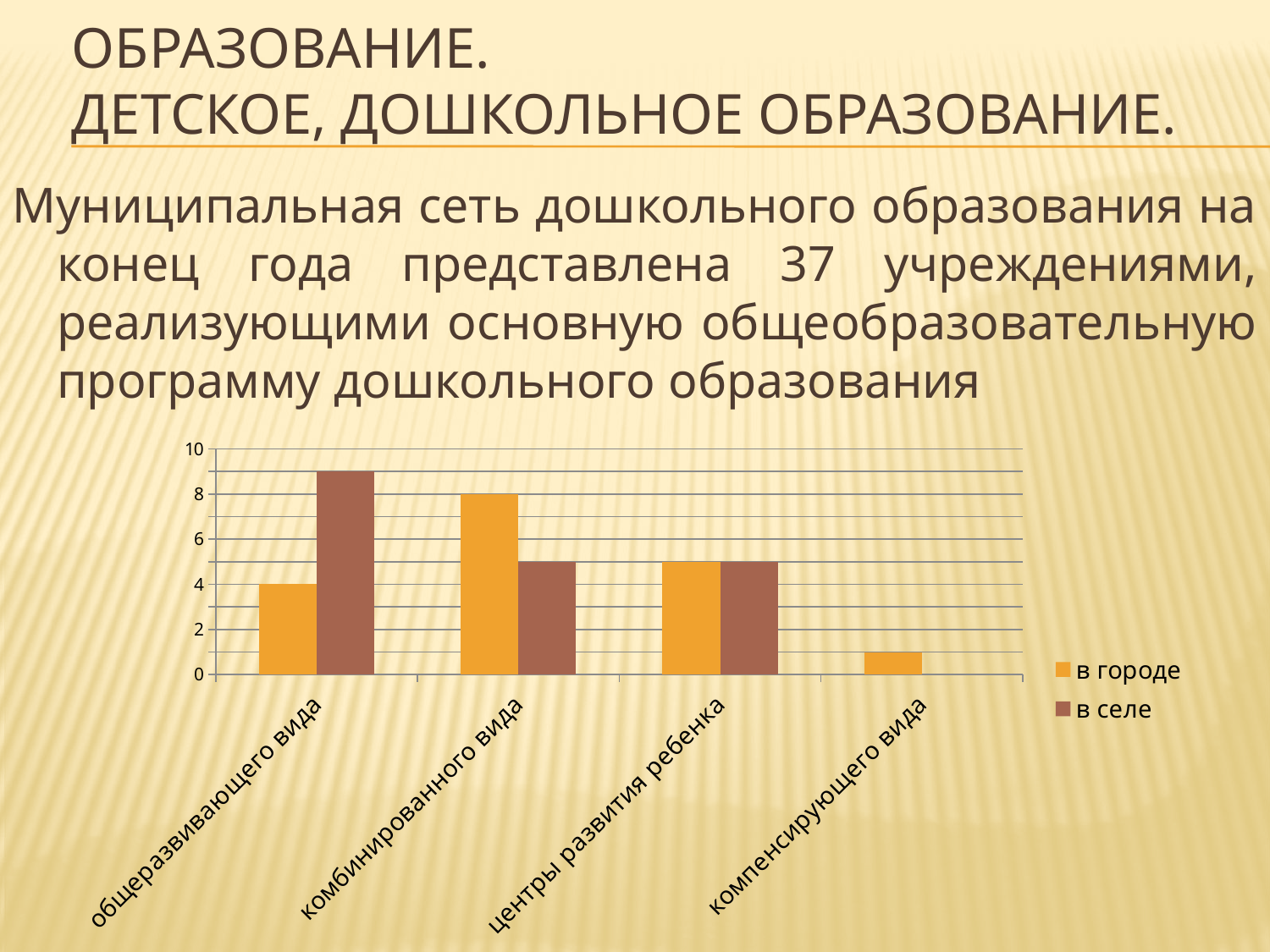
What is the value for 'в городе' in the category 'комбинированного вида'? 8 Is the value for 'в селе' in the category 'общеразвивающего вида' greater or less than 8? greater Which category has the highest value for 'в селе'? общеразвивающего вида How many series does the chart legend list? 2 Is the value for 'в городе' in the category 'компенсирующего вида' greater or less than 2? less What is the value for 'в городе' in the category 'общеразвивающего вида'? 4 In the category 'общеразвивающего вида', which is larger: 'в городе' or 'в селе'? в селе What is the difference between the 'в городе' values for 'комбинированного вида' and 'общеразвивающего вида'? 4 What kind of chart is shown on the slide? bar chart How many categories are shown on the x axis of the chart? 4 Which category has the highest value for 'в городе'? комбинированного вида Which category has the lowest value for 'в городе'? компенсирующего вида